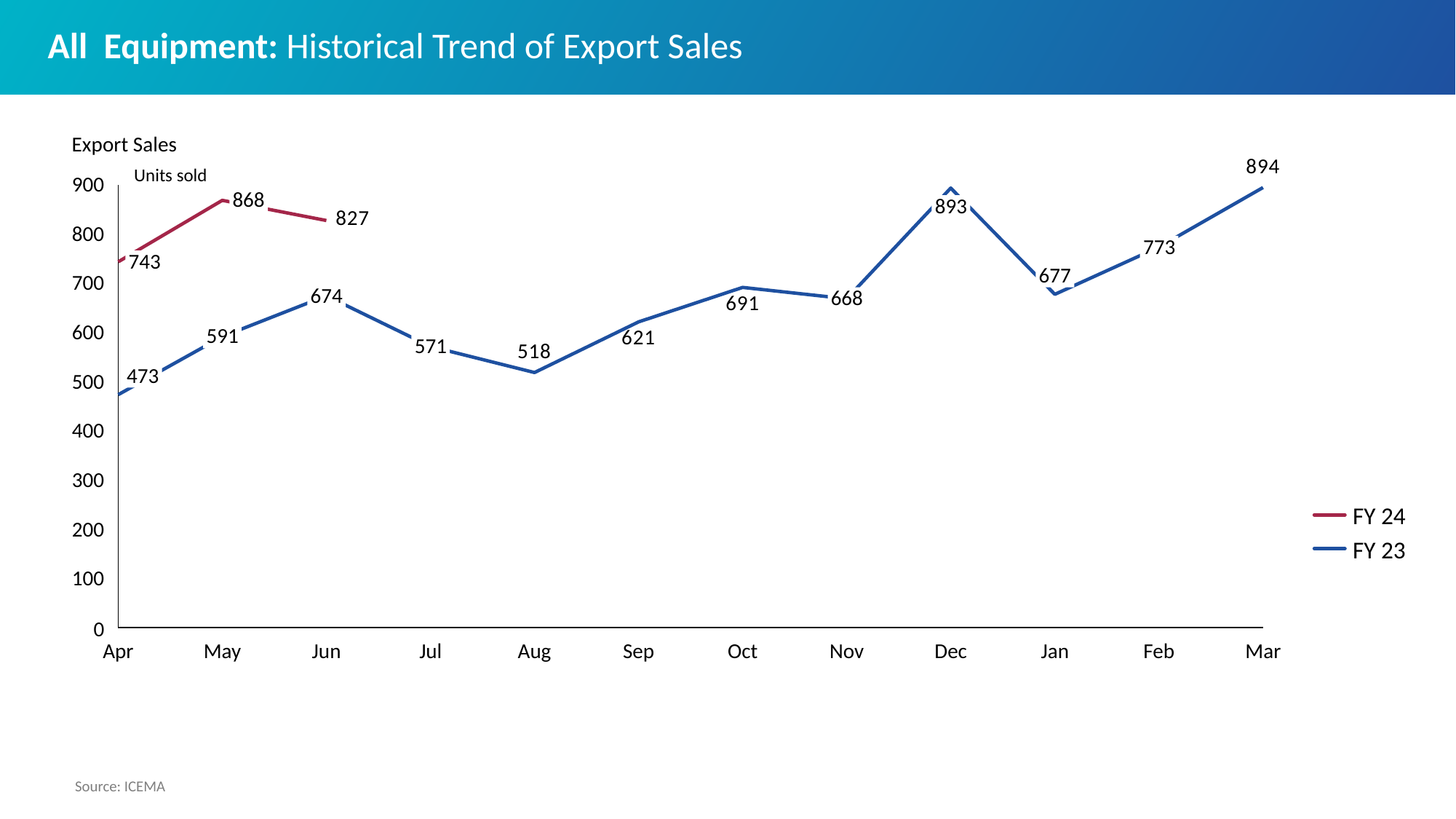
Which month has the lowest FY 23 export sales? Apr Do FY 23 export sales rise or fall from Jan to Mar? Rise How many series does the legend list? 2 What is the FY 23 export sales value for Dec? 893 What is the difference between FY 24 and FY 23 export sales in Apr? 270 What is the source cited for the chart? ICEMA Which month has the highest FY 23 export sales? Mar What is the FY 23 export sales value for Aug? 518 What kind of chart is shown on the slide? Line chart Which is larger, FY 24 export sales in Jun or FY 23 export sales in Jun? FY 24 What is the FY 24 export sales value for May? 868 How many months are shown on the x axis? 12